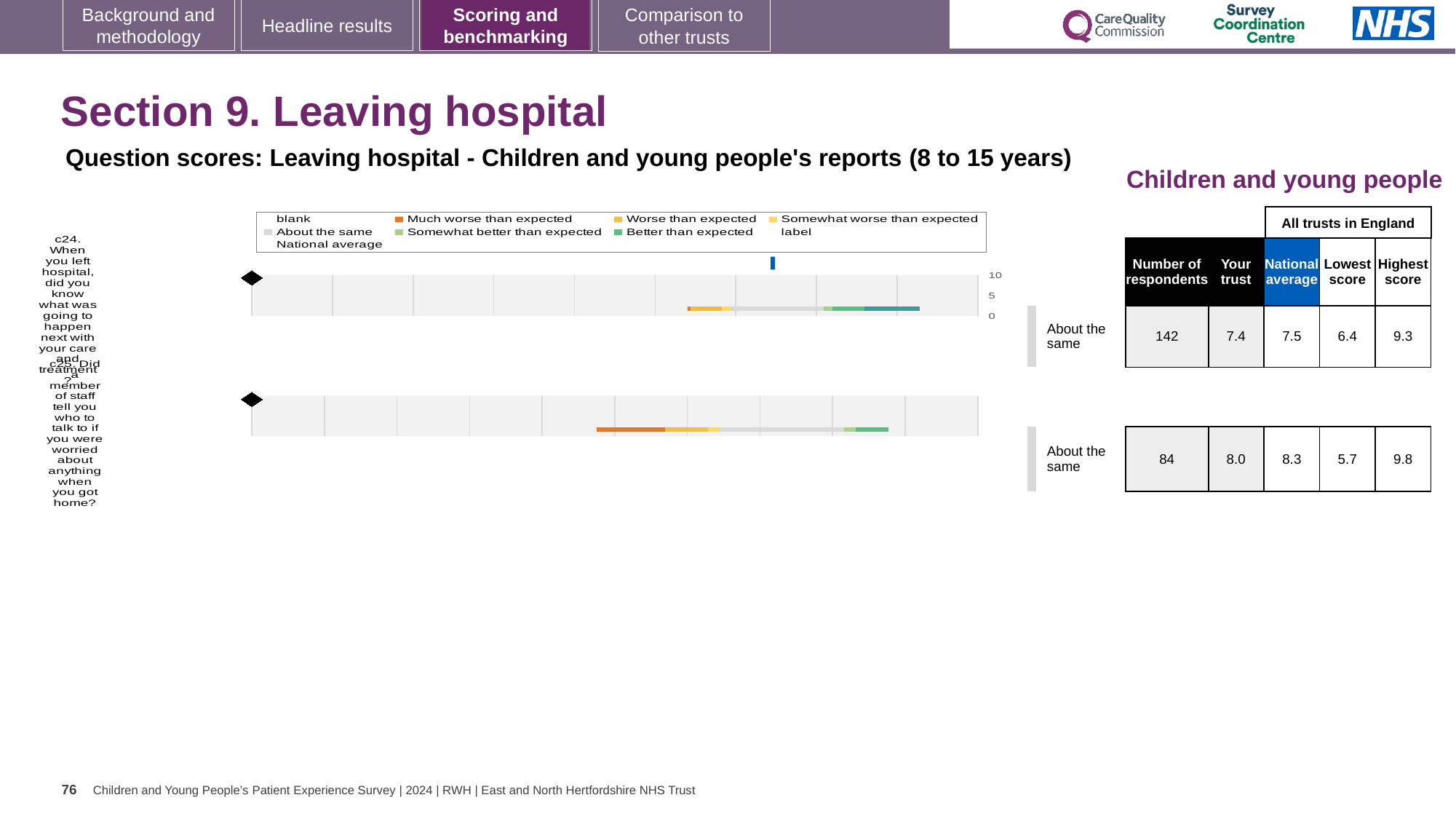
In the table, what is the number of respondents for question c24? 142 In the table, what is the 'Your trust' score for question c25? 8.0 In the table, what is the national average for question c24? 7.5 What is the highest value shown on the chart's axis? 10 What benchmark category is given for question c24? About the same What is the difference between the national average and the 'Your trust' score for question c25? 0.3 In the table, what is the highest score for question c25? 9.8 In the table, what is the lowest score for question c24? 6.4 Which colour in the legend represents 'Much worse than expected'? orange Which question has the higher 'Your trust' score, c24 or c25? c25 How many questions (bars) are plotted in the chart? 2 What kind of chart is shown on the slide? bar chart